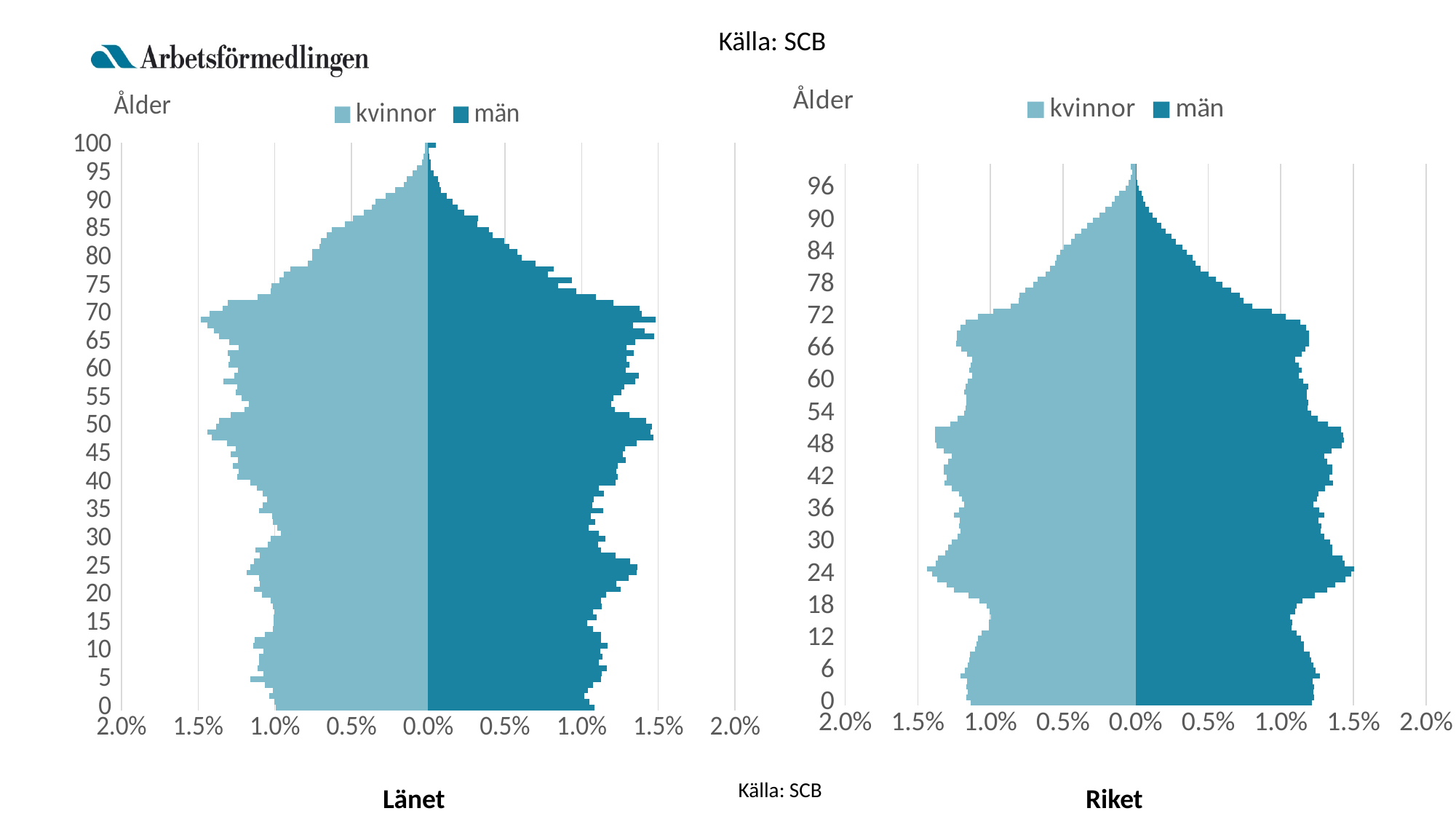
In the Länet chart, is the value for kvinnor at age 95 greater or less than 0.5%? less How many series does the legend of the Riket chart list? 2 In the Riket chart, is the value for kvinnor at age 90 greater or less than 0.5%? less What kind of chart is the Länet chart? bar chart In the Länet chart, which is larger: the value for män at age 50 or the value for män at age 90? män at age 50 In the Länet chart, is the value for kvinnor at age 68 greater or less than 1.0%? greater What source is cited for the charts on the slide? SCB In the Riket chart, which is larger: the value for kvinnor at age 24 or the value for kvinnor at age 96? kvinnor at age 24